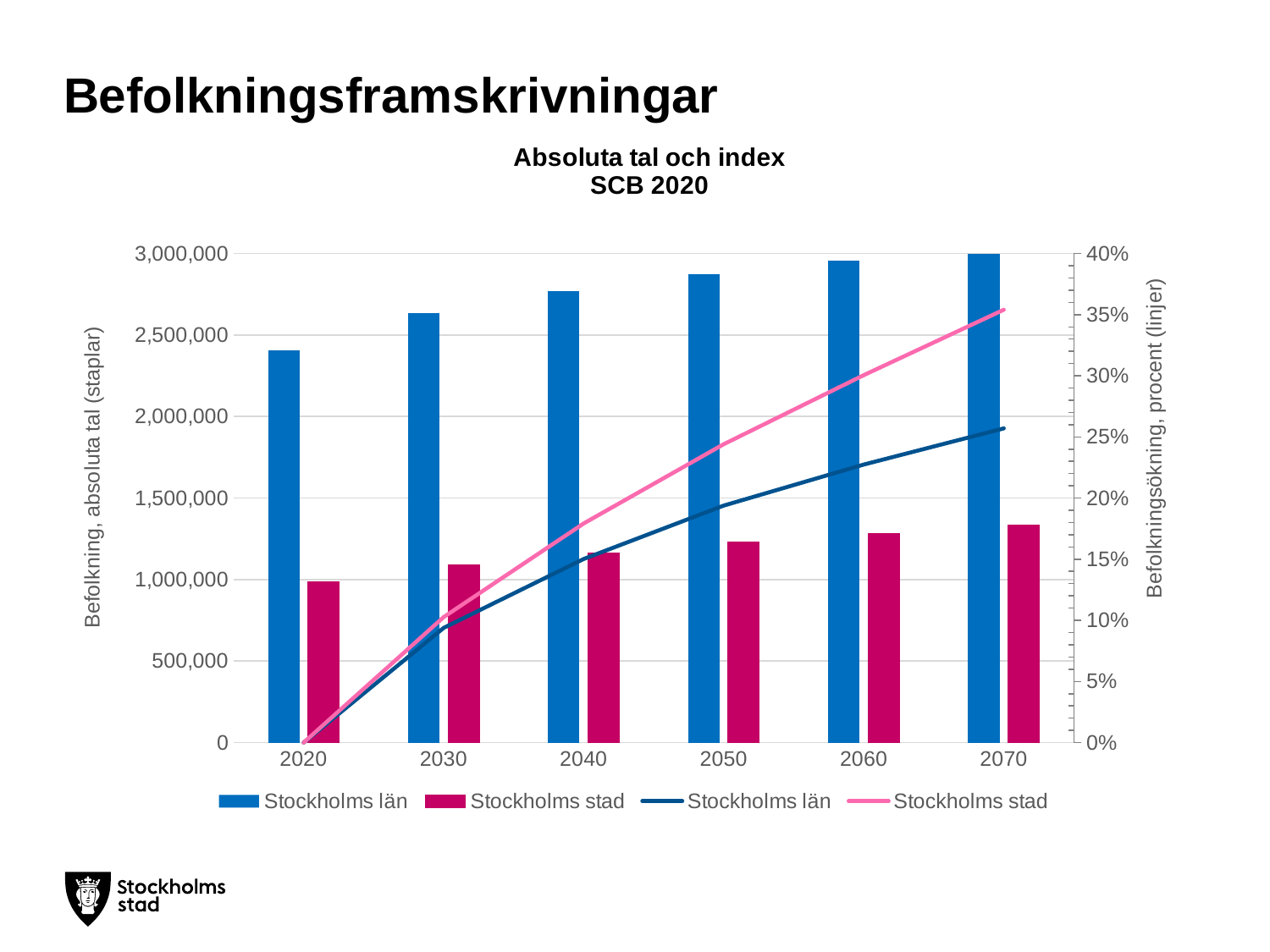
Is the Stockholms län line value for 2070 greater or less than 30%? less Is the Stockholms stad bar for 2030 greater or less than 1,000,000? greater What kind of chart is shown on the slide? bar and line chart Is the Stockholms län bar for 2020 greater or less than 2,000,000? greater How many years are shown on the x axis? 6 How many entries does the legend list? 4 Do the Stockholms län bars rise or fall from 2020 to 2070? rise In 2050, which line is higher, Stockholms stad or Stockholms län? Stockholms stad In which year is the Stockholms län bar highest? 2070 In which year is the Stockholms stad bar lowest? 2020